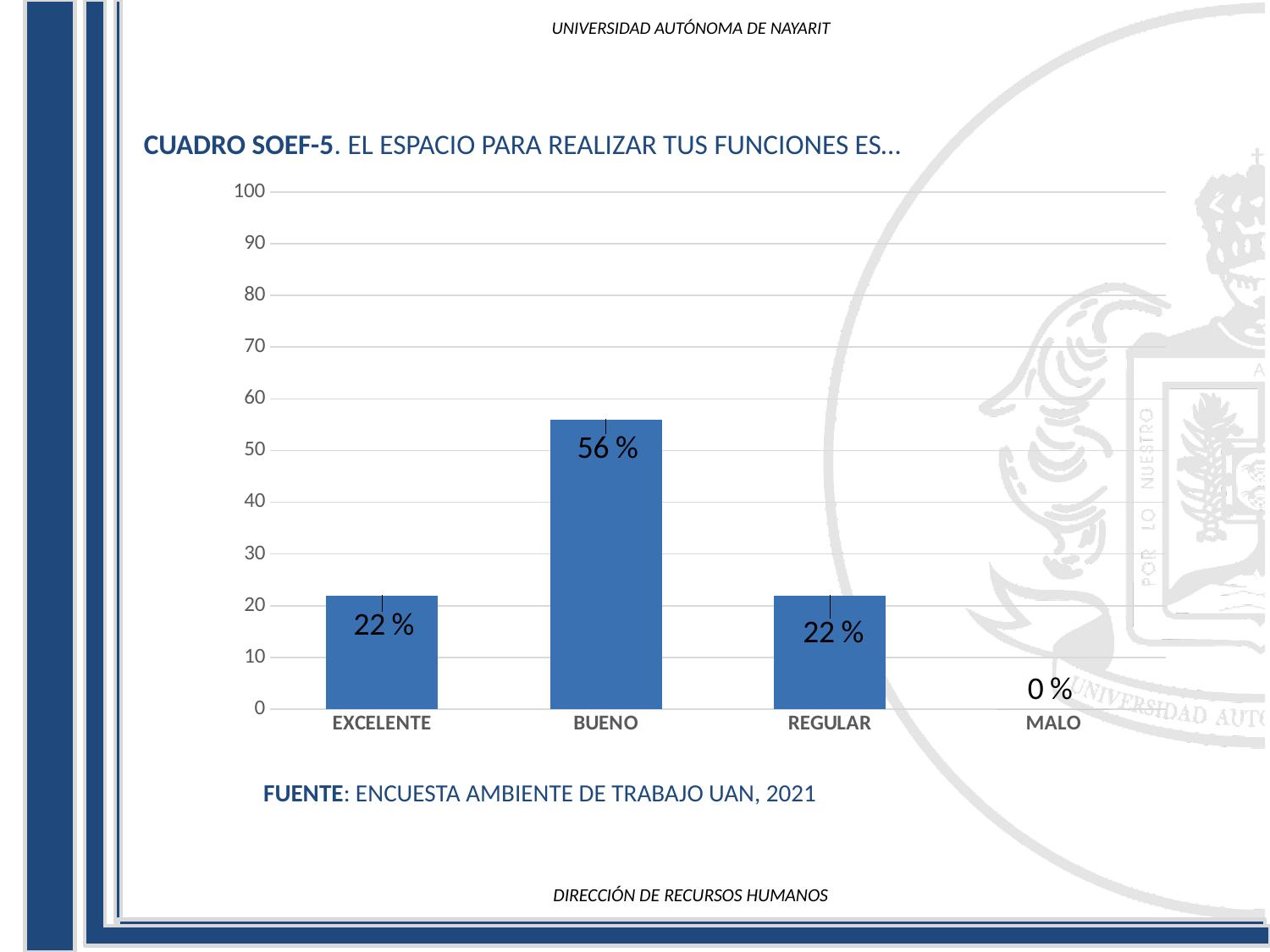
What is the value for MALO? 0 % What is the value for BUENO? 56 % What is the source cited below the chart? ENCUESTA AMBIENTE DE TRABAJO UAN, 2021 Which category has the highest value? BUENO Is the value for BUENO greater or less than 50? greater What is the value for EXCELENTE? 22 % Which category has the lowest value? MALO Which is larger, the value for BUENO or the value for EXCELENTE? BUENO How many categories are shown on the x axis? 4 What is the difference between the values for BUENO and REGULAR? 34 % What kind of chart is shown on the slide? bar chart What is the maximum value shown on the y axis? 100